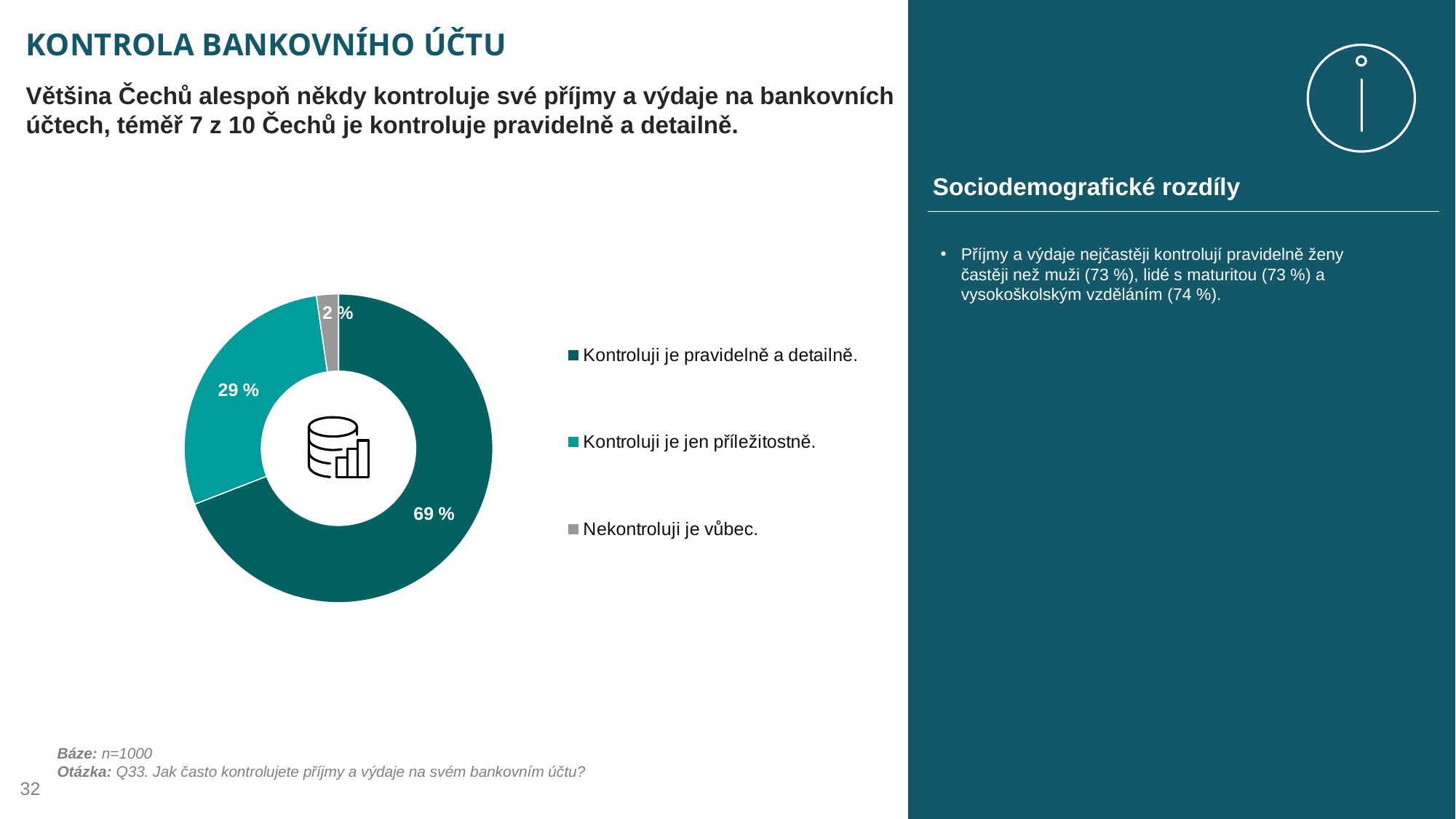
Which category has the smallest share of the pie? Nekontroluji je vůbec. What is the difference in percentage points between "Kontroluji je jen příležitostně." and "Nekontroluji je vůbec."? 27 Which is larger: the share for "Kontroluji je jen příležitostně." or for "Nekontroluji je vůbec."? Kontroluji je jen příležitostně. What share of respondents answered "Kontroluji je pravidelně a detailně."? 69 % What share of respondents answered "Kontroluji je jen příležitostně."? 29 % Which category has the largest share of the pie? Kontroluji je pravidelně a detailně. How many categories does the pie chart show? 3 What share of respondents answered "Nekontroluji je vůbec."? 2 % What is the base (n) stated for the chart? n=1000 What is the difference in percentage points between "Kontroluji je pravidelně a detailně." and "Kontroluji je jen příležitostně."? 40 What kind of chart is shown on the slide? Pie chart (doughnut) What colour is the slice for "Nekontroluji je vůbec."? Grey